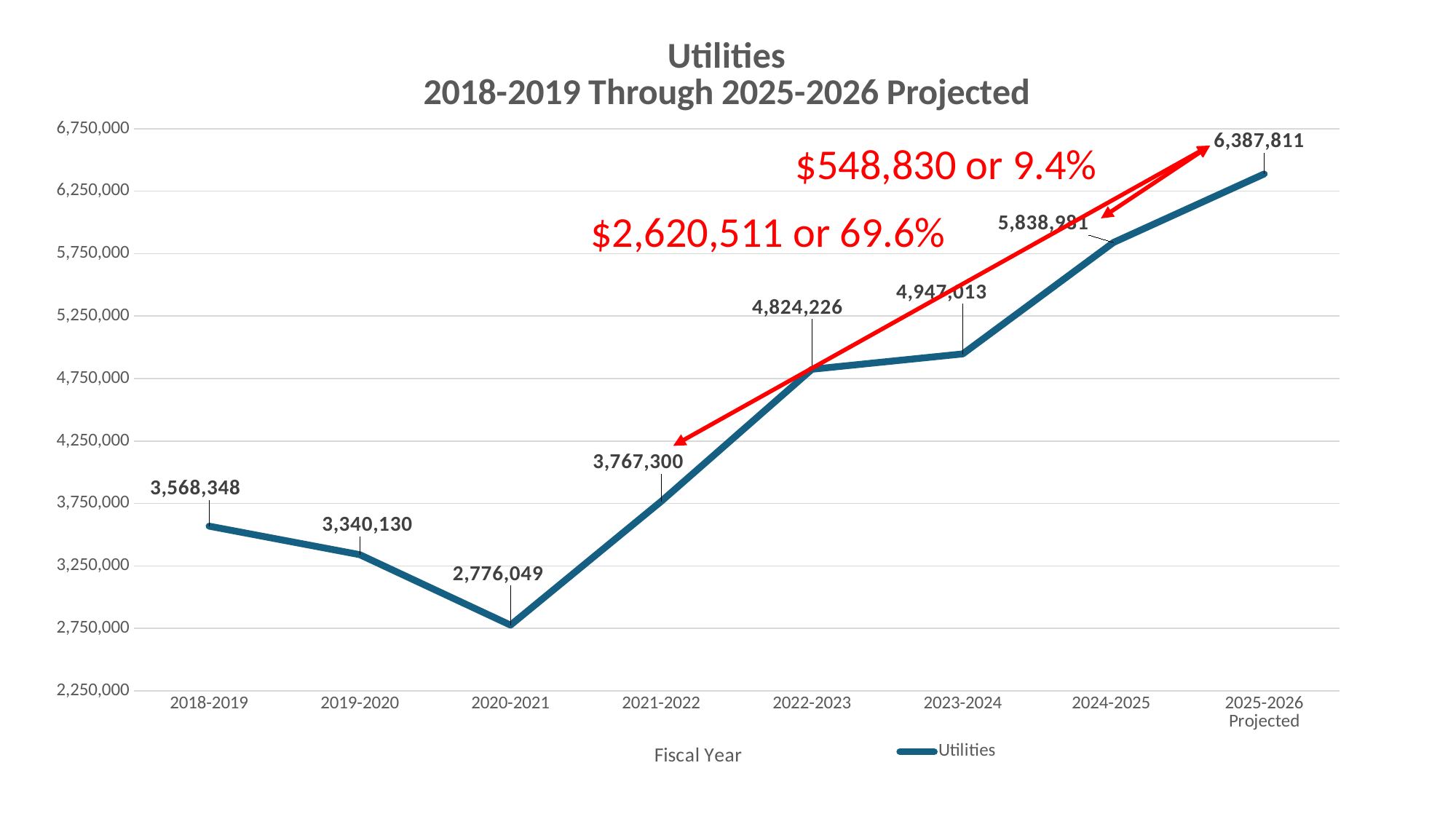
Which fiscal year has the highest value? 2025-2026 Projected What is the value for 2020-2021? 2,776,049 Which is larger, the value for 2021-2022 or the value for 2019-2020? 2021-2022 What is the value for 2018-2019? 3,568,348 What kind of chart is shown? line chart How many fiscal years are plotted on the chart? 8 What is the difference between the values for 2023-2024 and 2022-2023? 122,787 What is the difference between the values for 2018-2019 and 2019-2020? 228,218 What is the value for 2022-2023? 4,824,226 Which fiscal year has the lowest value? 2020-2021 Do the values rise or fall from 2020-2021 to 2025-2026 Projected? rise What is the value for 2025-2026 Projected? 6,387,811